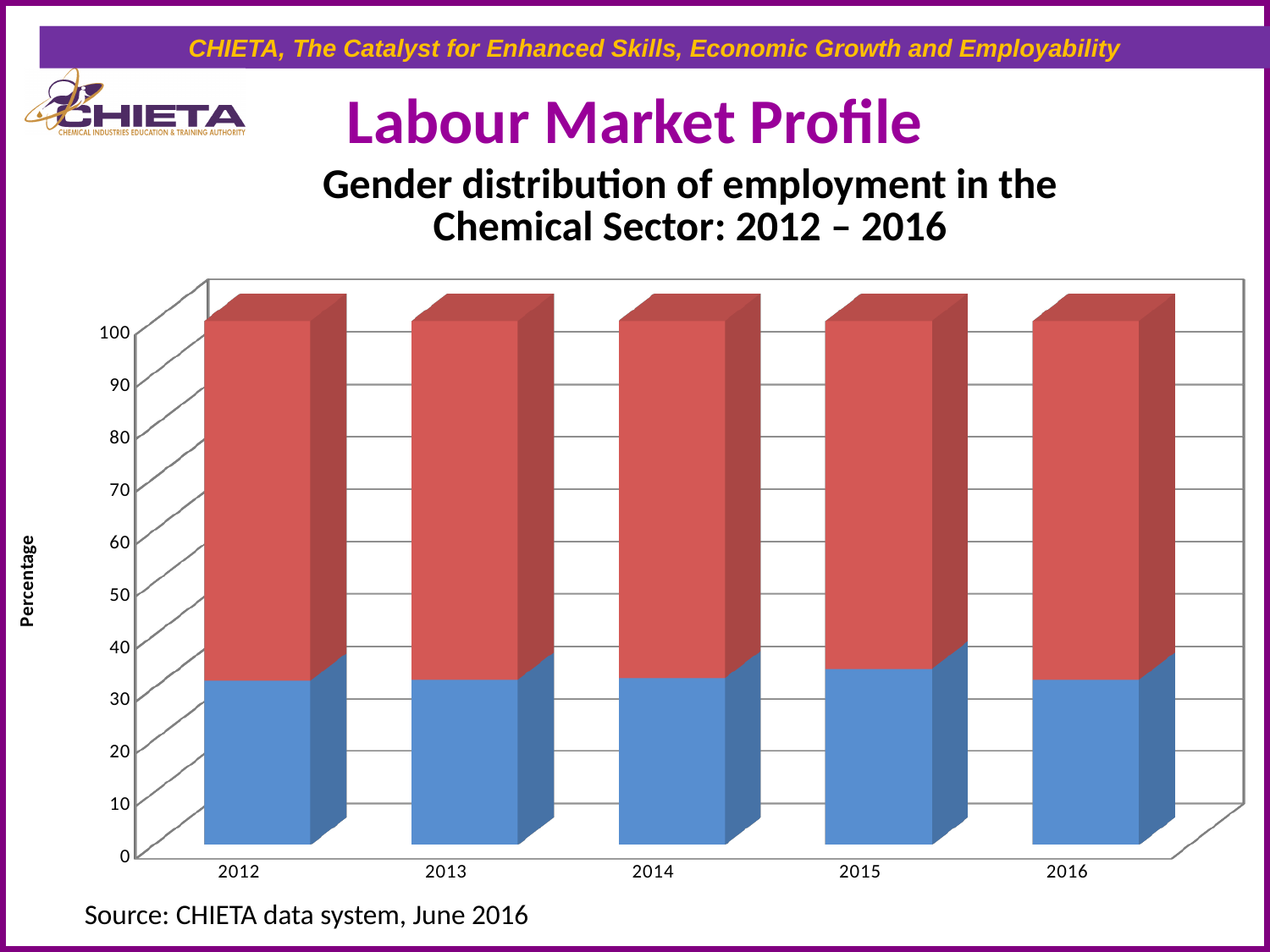
How many years are shown on the x axis of the chart? 5 What is the highest value shown on the vertical axis? 100 Is the blue segment for 2012 greater or less than 40? less What is the first year shown on the x axis? 2012 Is the red segment for 2014 greater or less than 50? greater What is the total height of the stacked bar for 2012? 100 Is the blue segment for 2015 greater or less than 30? greater What is the label on the vertical axis of the chart? Percentage Which is larger, the blue segment for 2015 or the blue segment for 2012? 2015 What kind of chart is shown on the slide? Stacked bar chart What is the title of the chart? Gender distribution of employment in the Chemical Sector: 2012 – 2016